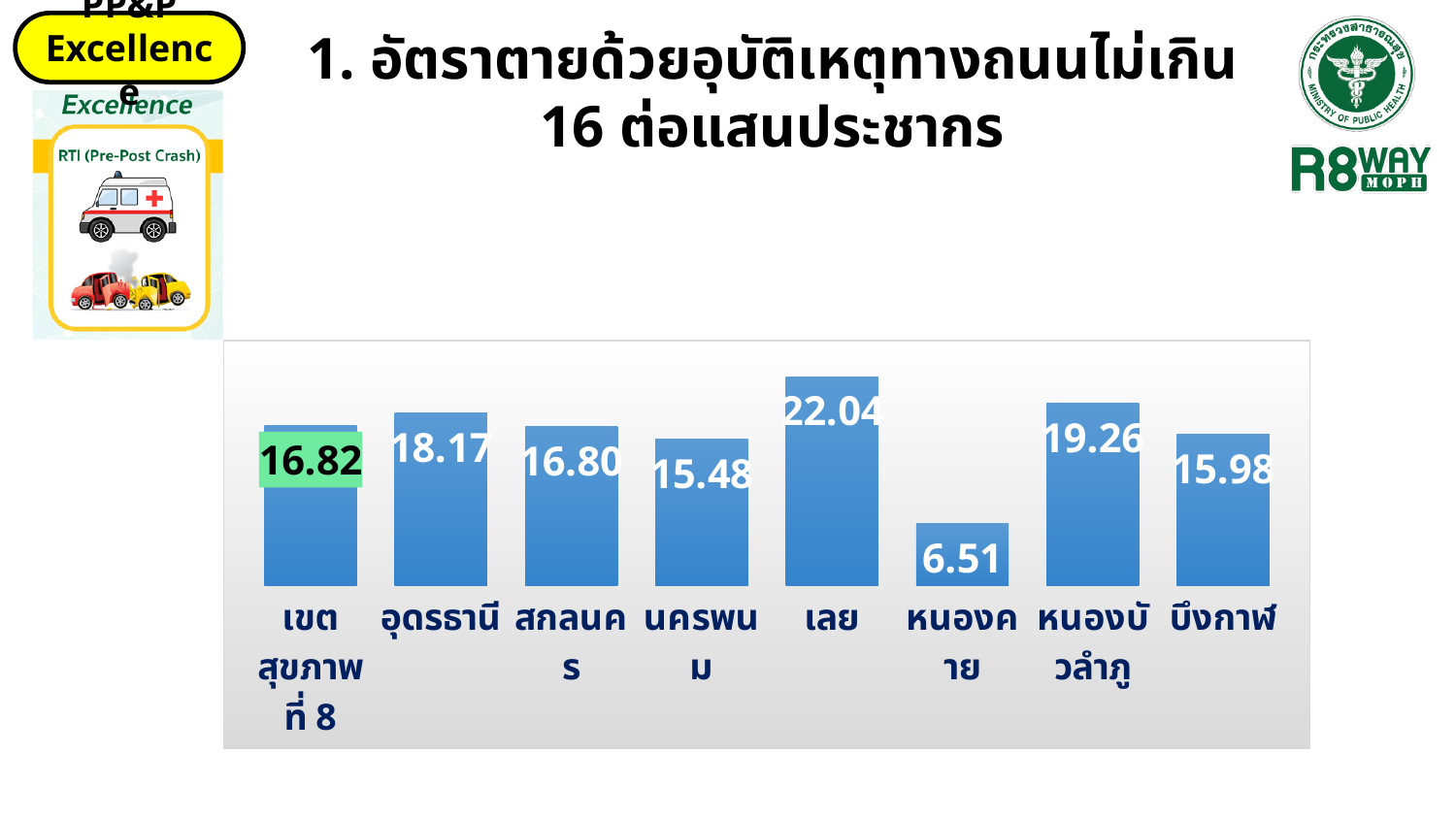
What is the value for เขตสุขภาพที่ 8? 16.82 How many categories are shown in the chart? 8 Which is larger, the value for หนองบัวลำภู or the value for บึงกาฬ? หนองบัวลำภู What is the value for หนองบัวลำภู? 19.26 What is the value for หนองคาย? 6.51 Which category has the lowest value? หนองคาย Which category has the highest value? เลย What is the difference between the values for เลย and หนองคาย? 15.53 Which category's data label is highlighted with a green background? เขตสุขภาพที่ 8 What is the difference between the values for อุดรธานี and นครพนม? 2.69 What is the value for เลย? 22.04 What kind of chart is shown on the slide? bar chart